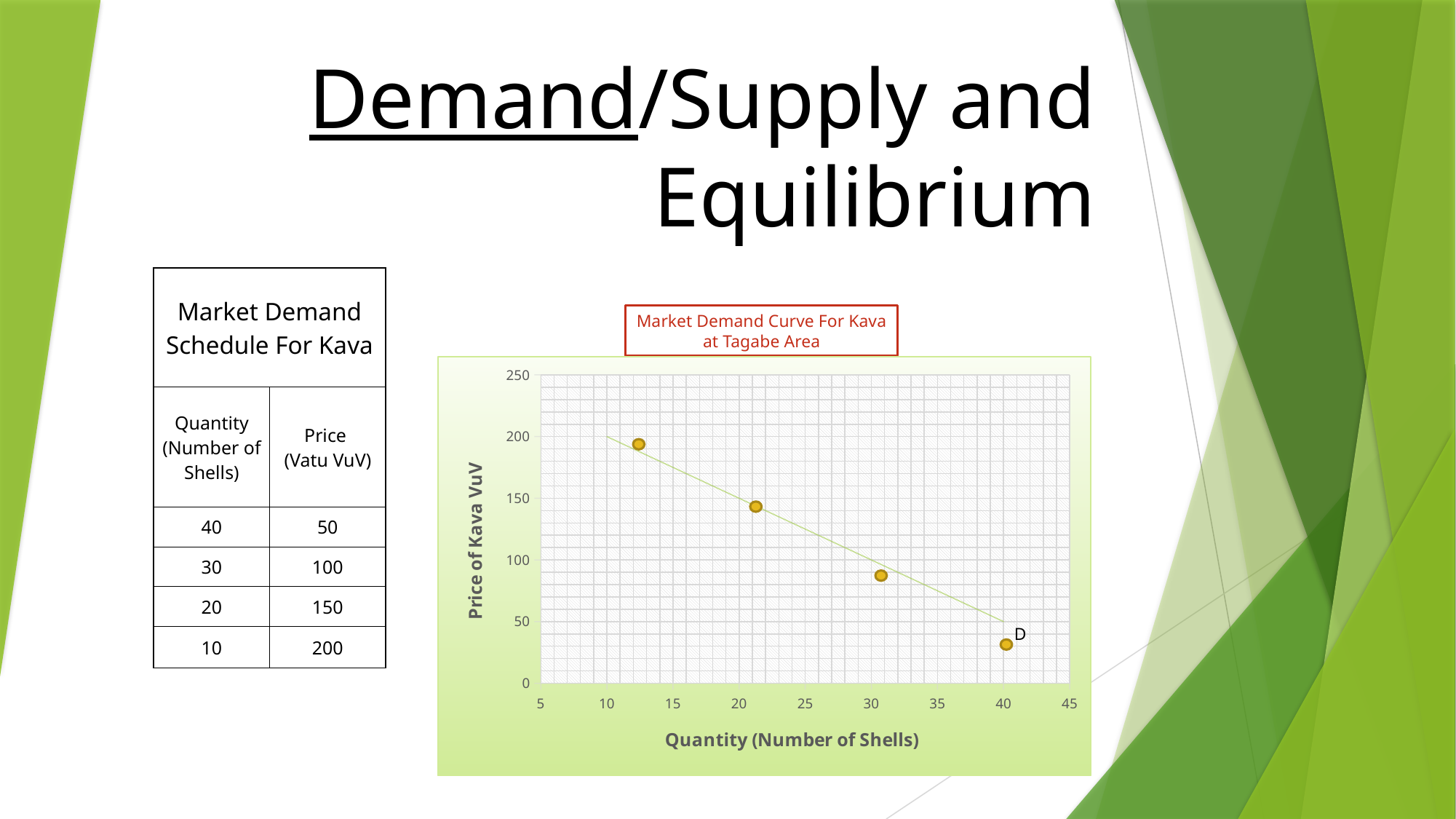
Is the price for the data point nearest quantity 10 greater or less than 150? greater Which data point has the highest price: the one nearest quantity 10 or the one nearest quantity 40? the one nearest quantity 10 Is the price for the data point nearest quantity 20 greater or less than 100? greater Is the price for the data point nearest quantity 30 greater or less than 50? greater How many data points are plotted on the chart? 4 What kind of chart is shown on the slide? scatter chart What is the title of the chart? Market Demand Curve For Kava at Tagabe Area As quantity increases along the x axis, does the price of kava rise or fall? fall What is the label on the x axis of the chart? Quantity (Number of Shells)